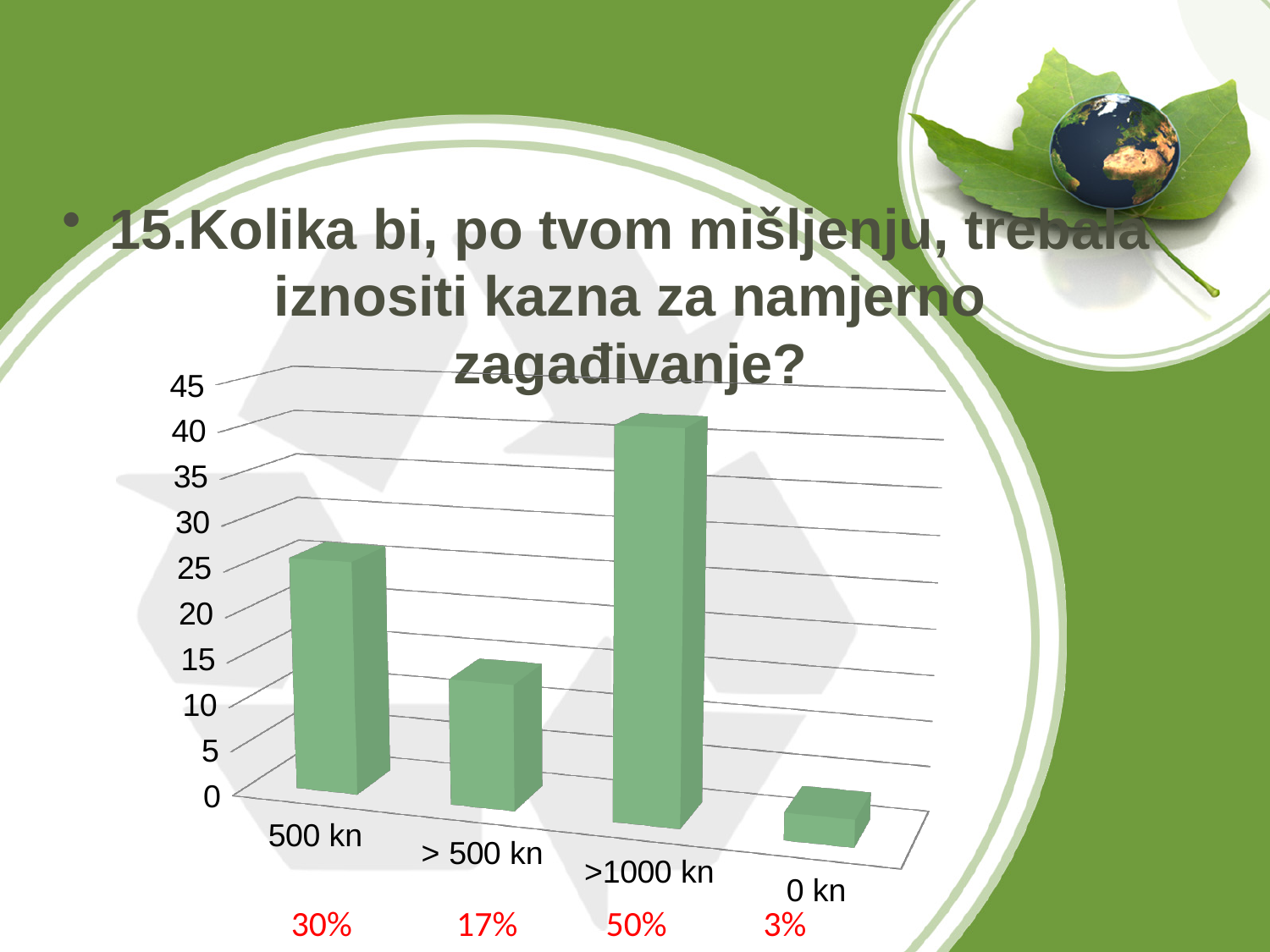
Is the value for 500 kn greater or less than 20? greater Is the value for >1000 kn greater or less than 35? greater How many categories are shown on the x axis of the chart? 4 Is the value for > 500 kn greater or less than 20? less What percentage is printed below the > 500 kn category? 17% What percentage is printed below the >1000 kn category? 50% What is the highest value shown on the vertical axis of the chart? 45 Which bar is taller: 500 kn or > 500 kn? 500 kn Which category has the lowest bar in the chart? 0 kn What kind of chart is shown on the slide? bar chart Which category has the highest bar in the chart? >1000 kn